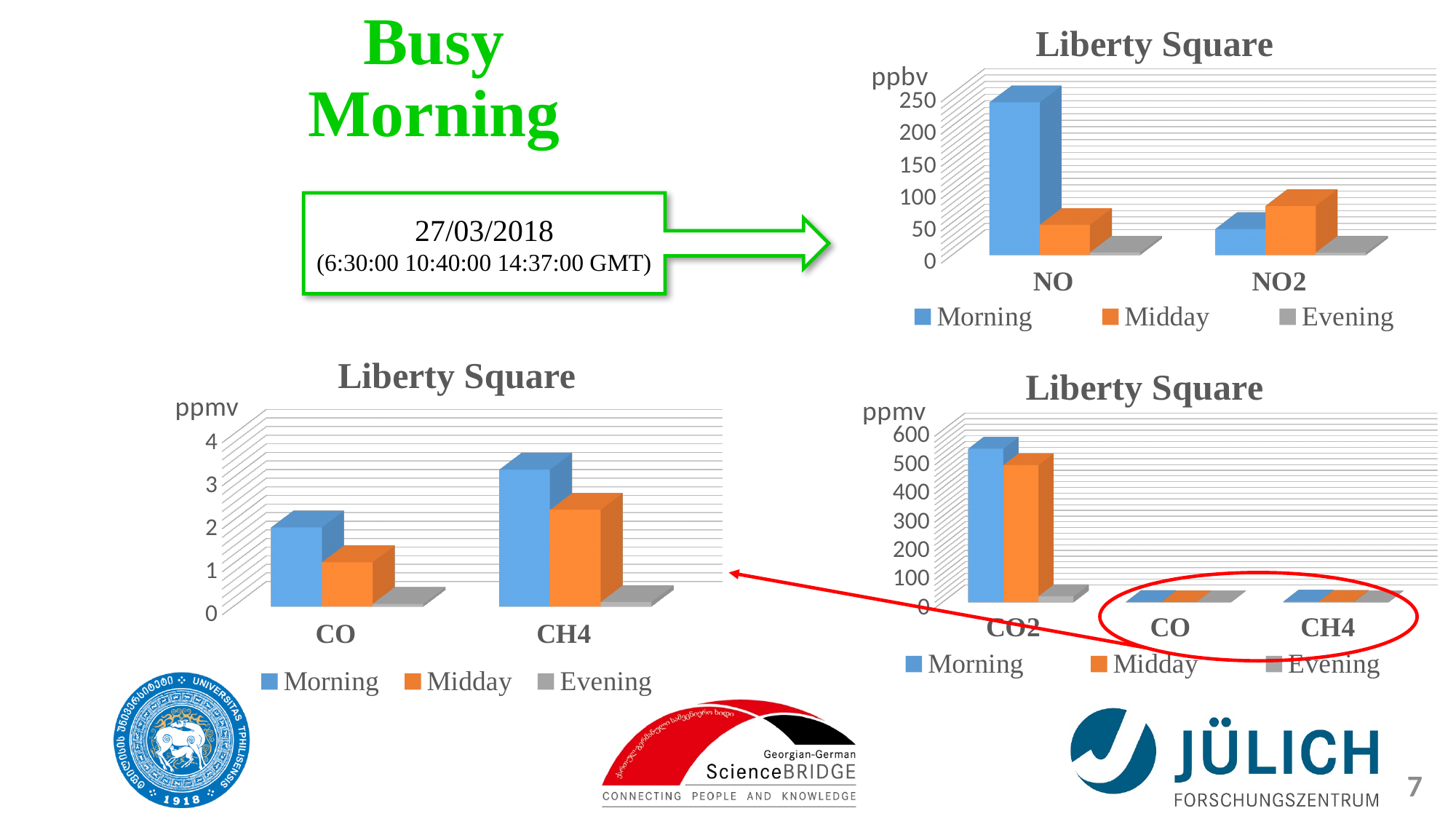
In the bottom-left Liberty Square chart (ppmv), is the Midday value for CO greater or less than 2? less What kind of chart is the bottom-right Liberty Square chart? bar chart In the top-right Liberty Square chart (ppbv), how many categories are shown on the x axis? 2 In the top-right Liberty Square chart (ppbv), how many series does the legend list? 3 In the bottom-right Liberty Square chart (ppmv), how many categories are shown on the x axis? 3 In the bottom-right Liberty Square chart (ppmv), is the Morning value for CO2 greater or less than 400? greater In the bottom-left Liberty Square chart (ppmv), which category has the higher Morning value, CO or CH4? CH4 In the top-right Liberty Square chart (ppbv), which is larger for NO2, the Morning value or the Midday value? Midday In the top-right Liberty Square chart (ppbv), is the Morning value for NO greater or less than 200? greater What unit is shown on the y axis of the bottom-left Liberty Square chart? ppmv In the top-right Liberty Square chart (ppbv), which series has the highest value for NO? Morning